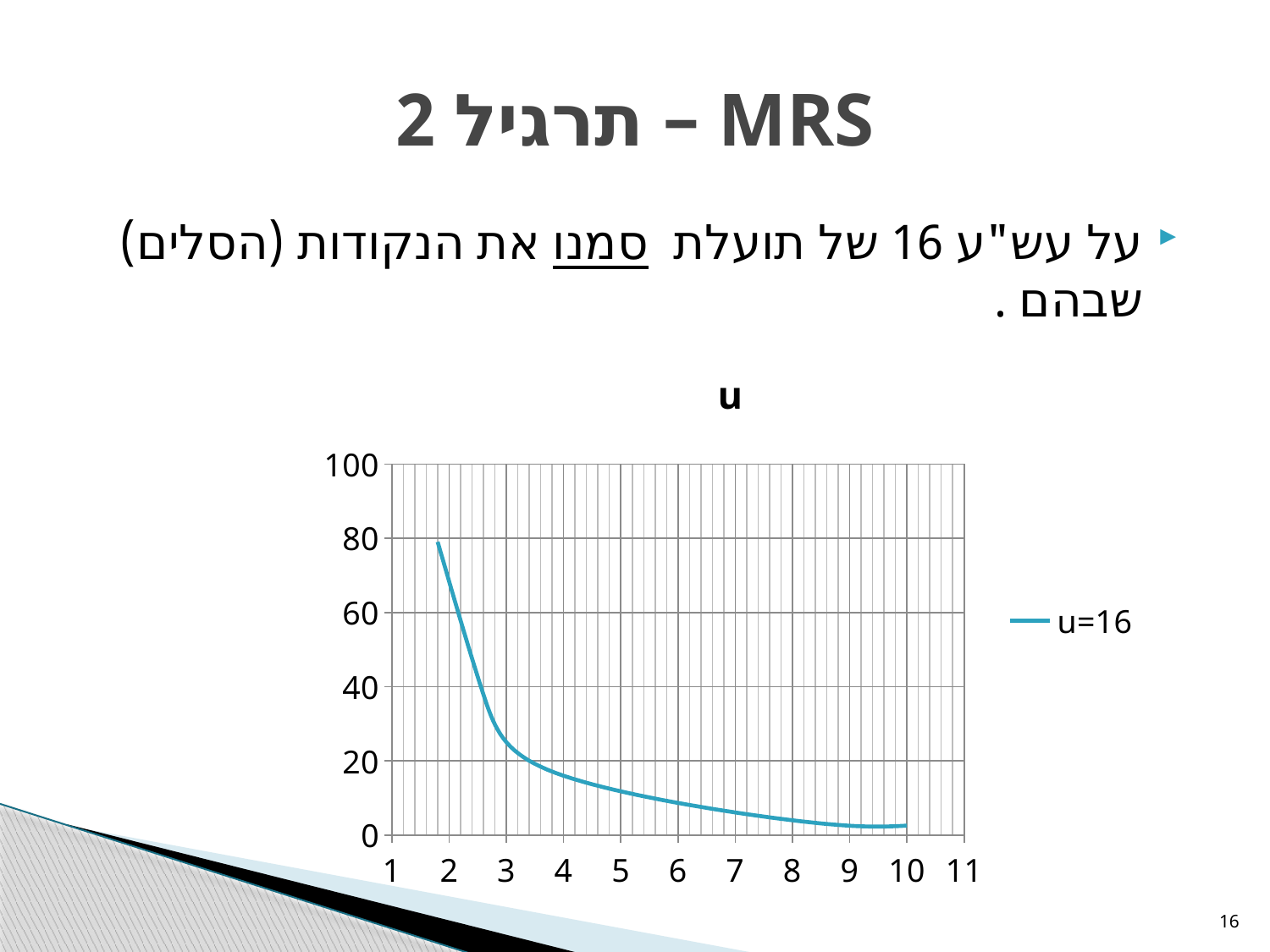
What is the highest value shown on the y axis? 100 What is the legend entry for the plotted series? u=16 What kind of chart is shown on the slide? line chart Is the value of the u=16 series at x=10 greater or less than 20? less Is the value of the u=16 series at x=3 greater or less than 40? less Is the value of the u=16 series at x=5 greater or less than 20? less Is the value of the u=16 series larger at x=2 or at x=6? x=2 How many series does the legend list? 1 What is the title of the chart? u Do the values of the u=16 series rise or fall as x increases from 2 to 10? fall